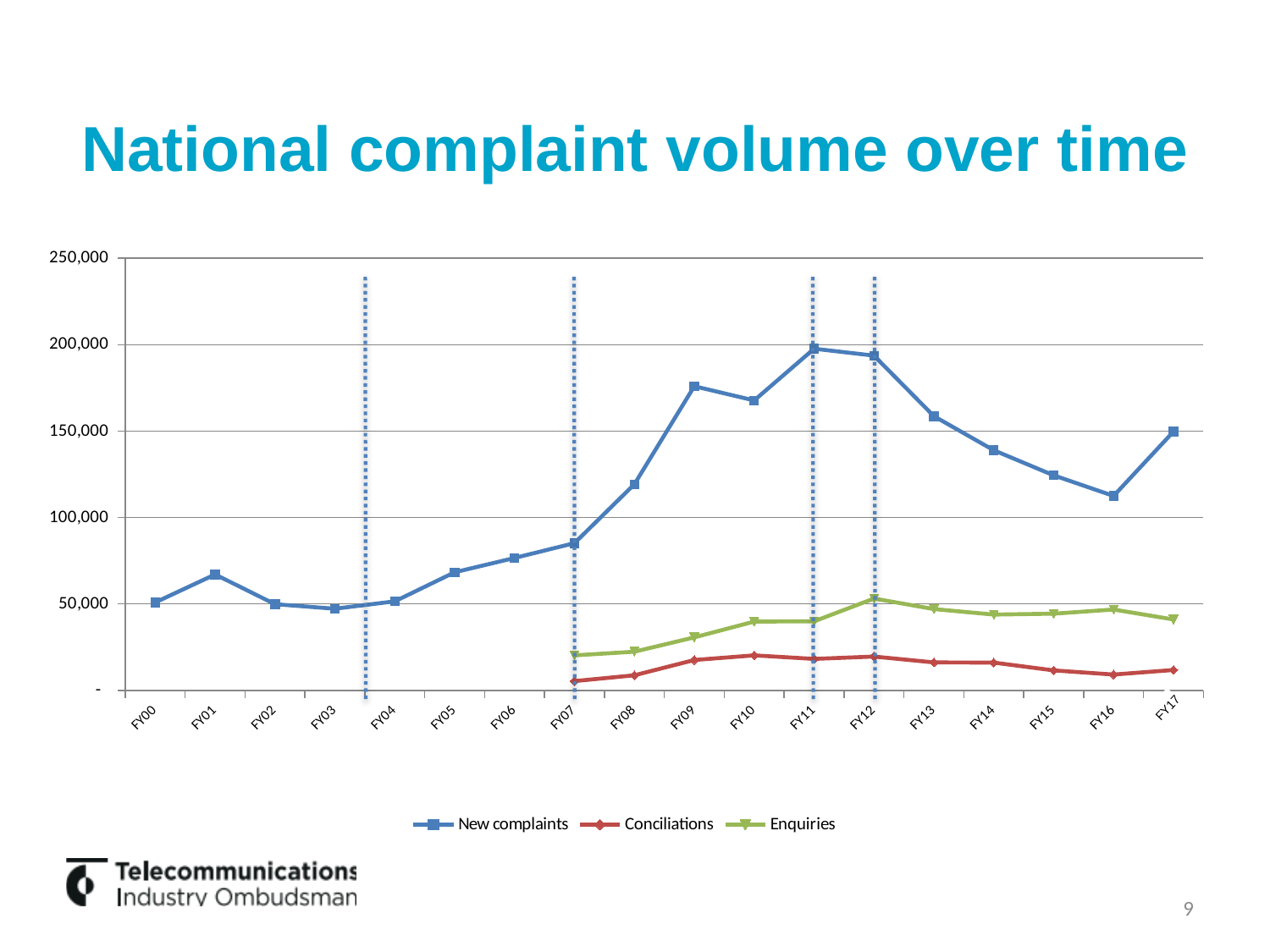
Do New complaints rise or fall from FY12 to FY16? fall Is the value for Conciliations in FY10 greater or less than 50,000? less Is the value for New complaints in FY16 greater or less than 150,000? less Is the value for New complaints in FY07 greater or less than 100,000? less Which series has the lowest value in FY17? Conciliations What kind of chart is shown on the slide? line chart What is the title of the chart? National complaint volume over time How many fiscal years are shown on the x axis? 18 Which series is drawn in green? Enquiries How many series does the legend list? 3 Which is larger for New complaints: FY08 or FY09? FY09